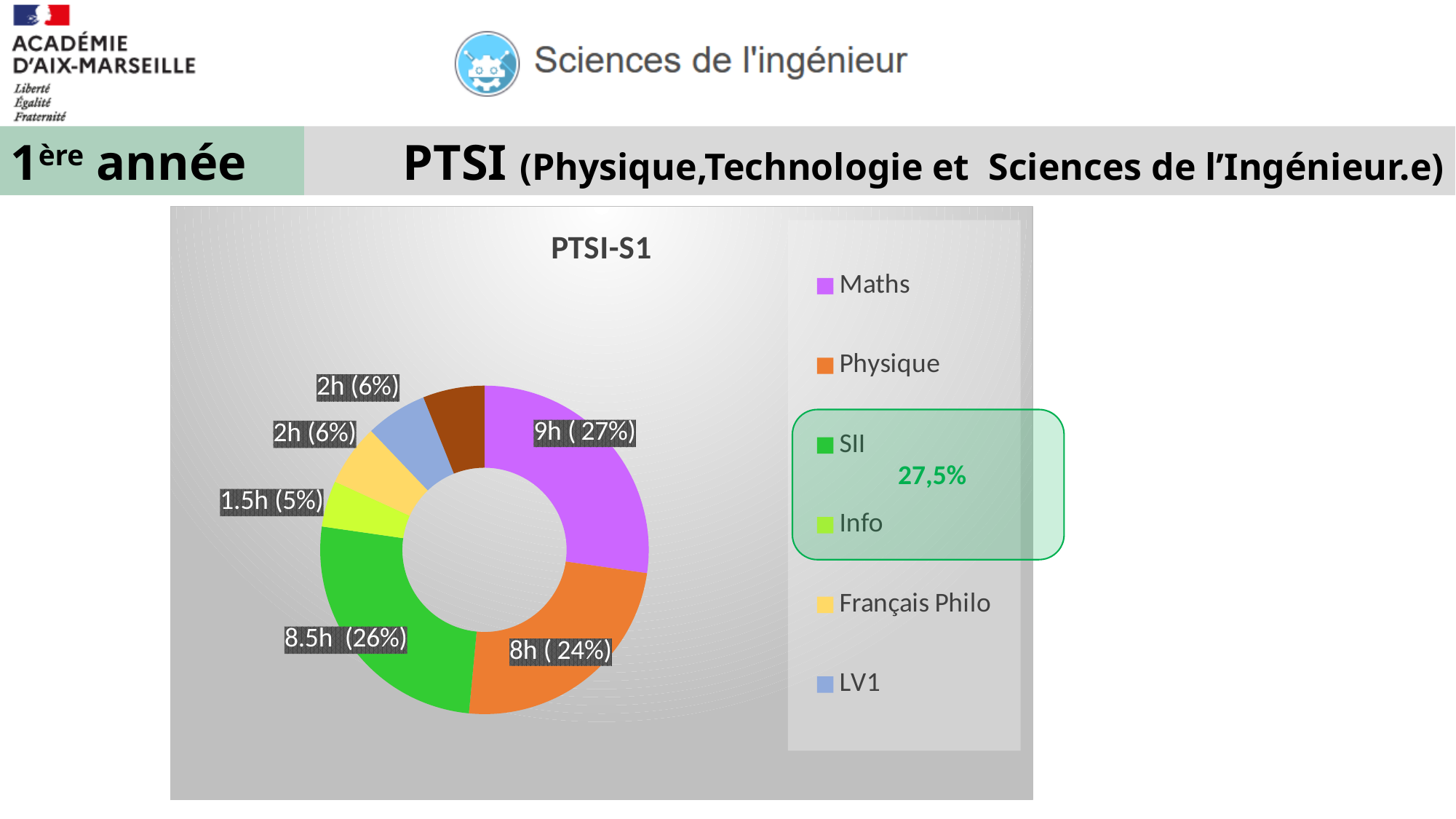
What is the data label for the Maths slice? 9h ( 27%) What is the data label for the Info slice? 1.5h (5%) Which has more hours, SII or Physique? SII What is the title of the chart? PTSI-S1 What kind of chart is shown on the slide? doughnut (pie) chart What share of the chart does the Maths slice represent? 27% What is the difference in hours between Maths and Physique? 1h Which labelled subject has the largest number of hours? Maths Which labelled subject has the smallest number of hours? Info What is the data label for the SII slice? 8.5h (26%) How many entries does the chart legend list? 6 What is the data label for the Physique slice? 8h ( 24%)